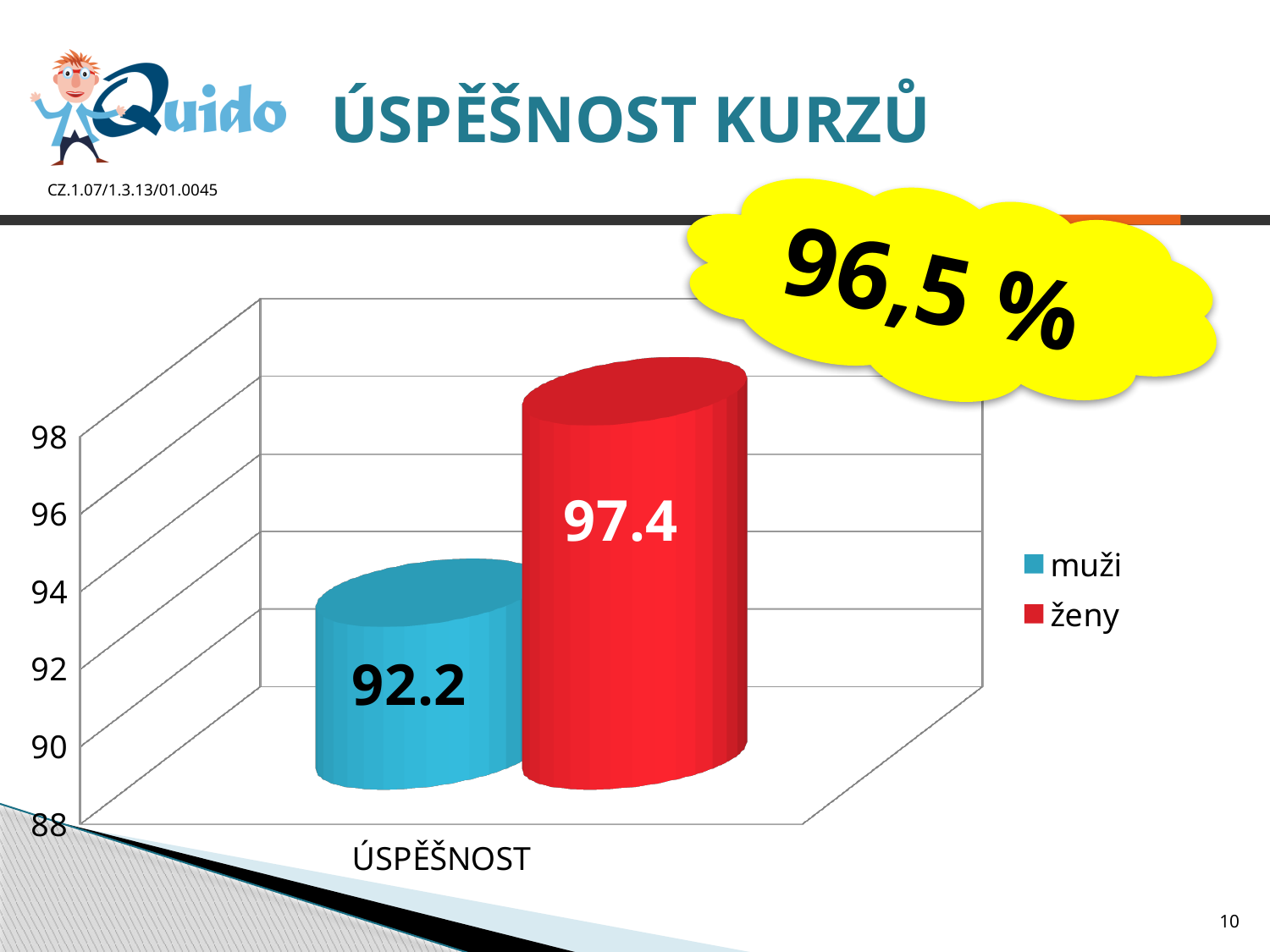
What kind of chart is shown on the slide? bar chart How many series does the legend list? 2 What is the value for muži in the chart? 92.2 What colour is the bar for ženy? red Which series has the highest value in the chart? ženy Is the value for muži greater or less than 94? less Which series has the higher value, muži or ženy? ženy What is the difference between the values for ženy and muži? 5.2 What is the value for ženy in the chart? 97.4 What is the category label shown on the x axis of the chart? ÚSPĚŠNOST Is the value for ženy greater or less than 96? greater Which series has the lowest value in the chart? muži